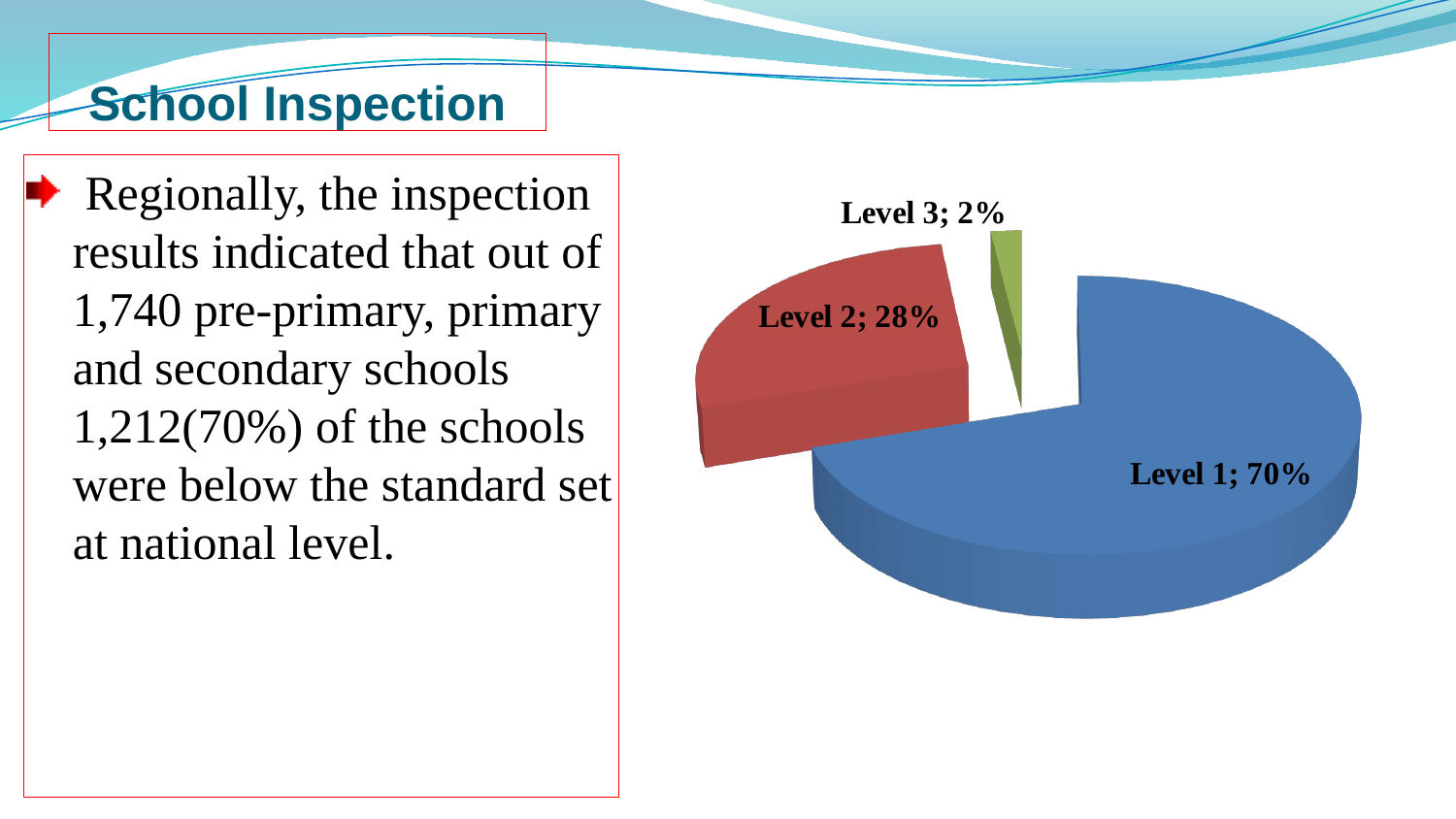
How many slices does the pie chart have? 3 What is the difference in percentage points between Level 1 and Level 2? 42 Which level has the largest slice of the pie? Level 1 What share of the pie does Level 3 represent? 2% Which level has the smallest slice of the pie? Level 3 What share of the pie does Level 2 represent? 28% What is the difference in percentage points between Level 2 and Level 3? 26 What share of the pie does Level 1 represent? 70% What colour is the Level 1 slice of the pie? blue Which is larger, the share for Level 2 or the share for Level 3? Level 2 What colour is the Level 2 slice of the pie? red What kind of chart is shown on the slide? pie chart